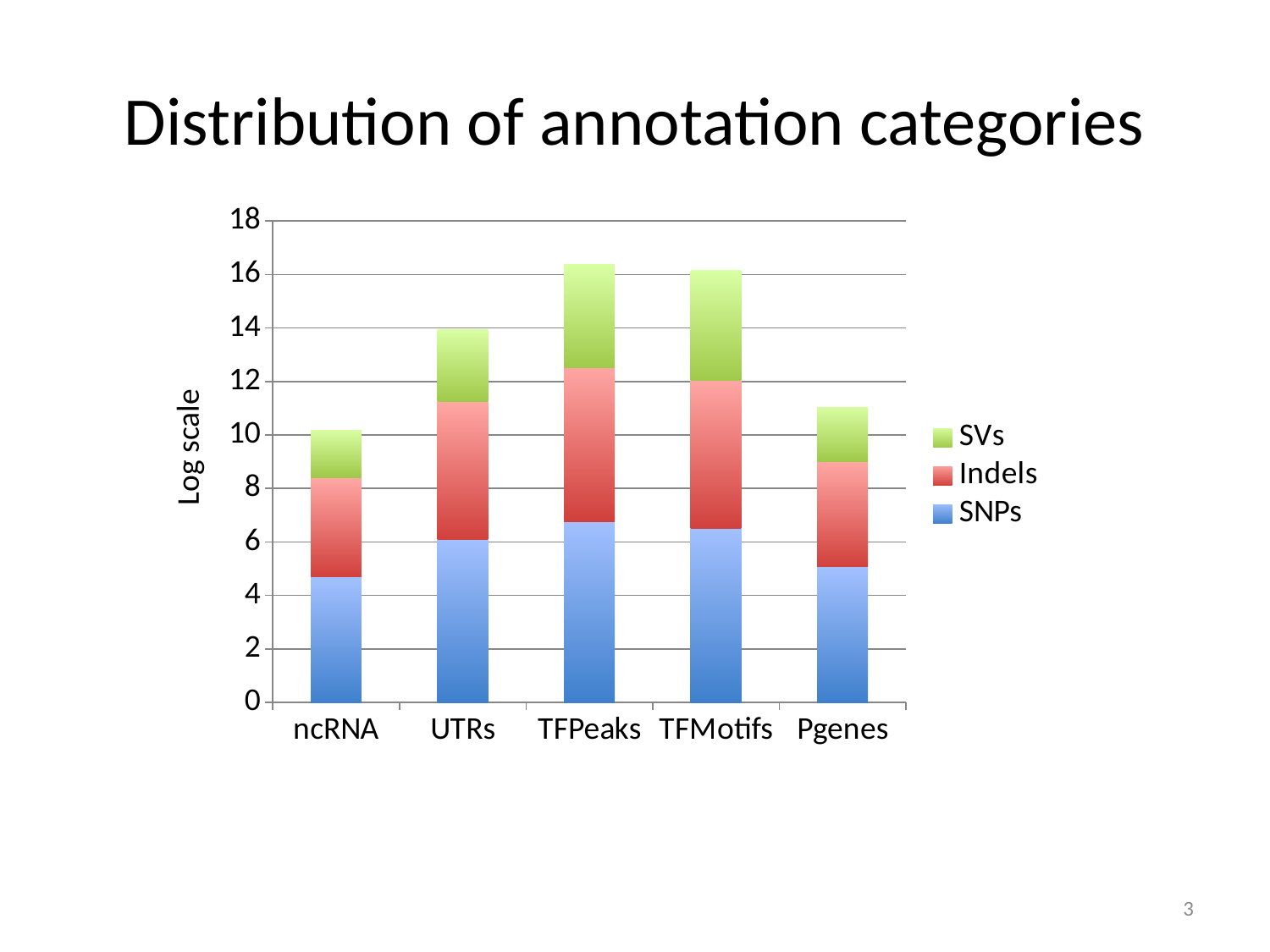
Is the total stacked value for ncRNA greater or less than 12? less How many annotation categories are shown on the x axis? 5 How many series does the legend list? 3 Is the total stacked value for TFPeaks greater or less than 14? greater Which category has the lowest total stacked bar? ncRNA Is the SNPs value for ncRNA greater or less than 6? less Which category has the smallest SNPs segment? ncRNA Which has the larger total stacked bar, UTRs or Pgenes? UTRs What is the label of the vertical axis? Log scale What kind of chart is shown on the slide? stacked bar chart What is the title of the chart? Distribution of annotation categories